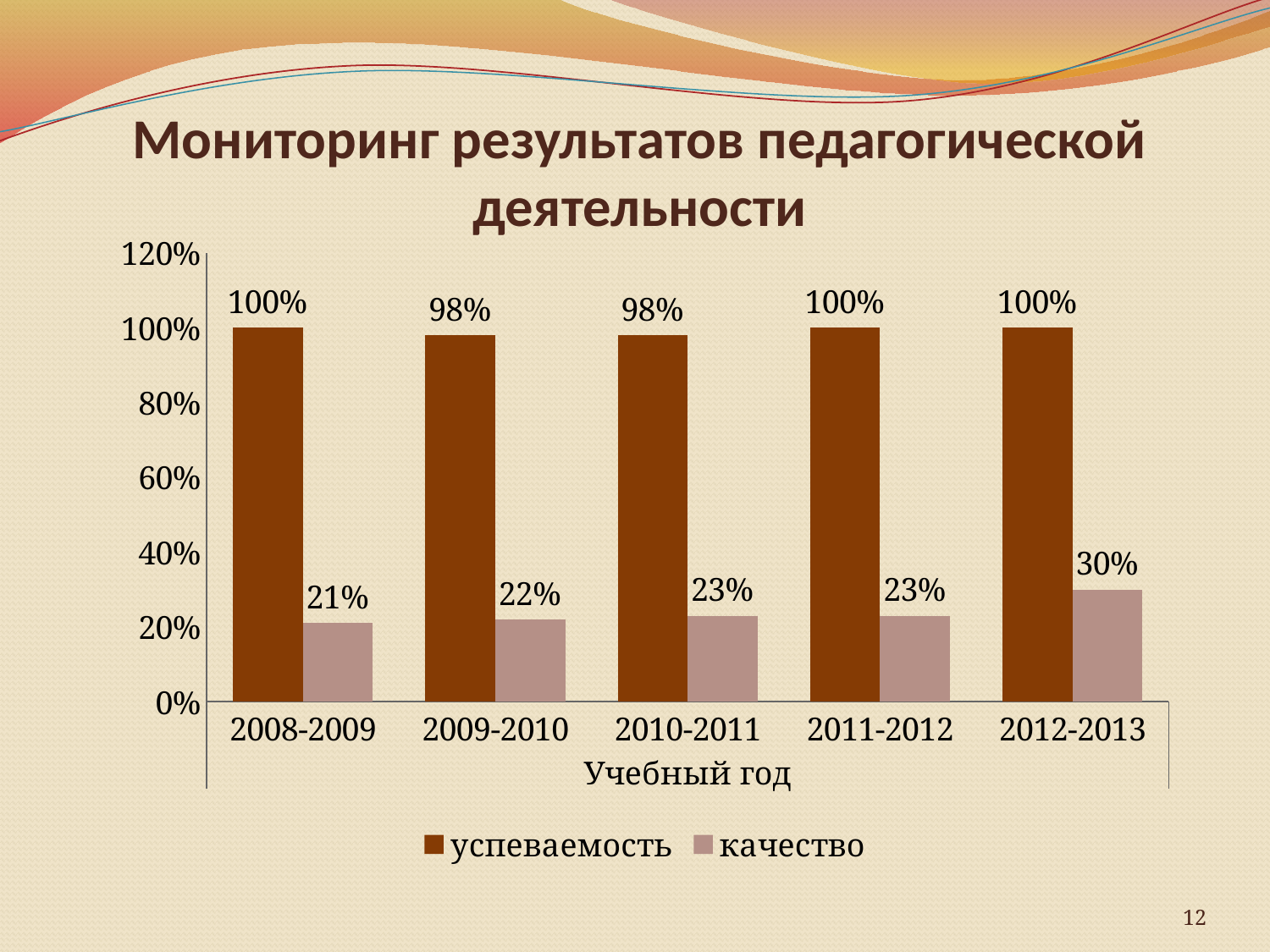
Does the value of качество rise or fall from 2008-2009 to 2012-2013? rise What is the value of качество for 2012-2013? 30% What is the value of успеваемость for 2009-2010? 98% Which is larger: качество in 2009-2010 or качество in 2012-2013? 2012-2013 How many series does the legend list? 2 Which academic year has the highest value for качество? 2012-2013 What is the difference between качество in 2012-2013 and качество in 2011-2012? 7% Which academic year has the lowest value for качество? 2008-2009 What kind of chart is shown on the slide? bar chart What is the value of качество for 2008-2009? 21% What is the difference between успеваемость and качество in 2010-2011? 75% How many academic years are shown on the x axis? 5